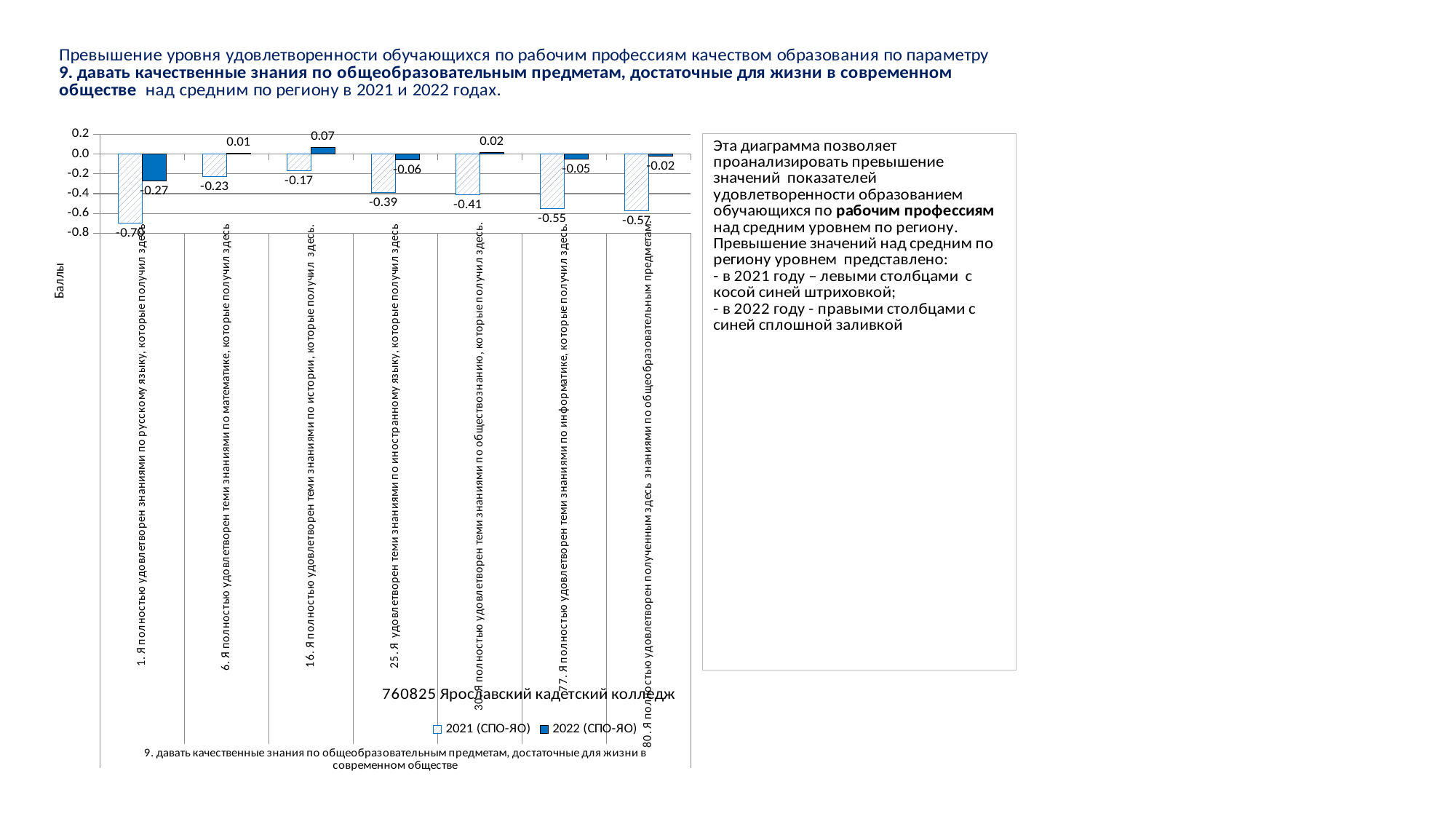
How many series does the chart legend list? 2 Which statement has the highest 2022 (СПО-ЯО) value? 16. Я полностью удовлетворен теми знаниями по истории, которые получил здесь What is the 2021 (СПО-ЯО) value for the statement about knowledge in informatics (77. ... по информатике)? -0.55 What is the 2022 (СПО-ЯО) value for the statement about knowledge in mathematics (6. ... по математике)? 0.01 How many categories (statements) are plotted on the x axis of the chart? 7 What is the difference between the 2022 and 2021 values for the statement about foreign language (25. ... по иностранному языку)? 0.33 What is the 2022 (СПО-ЯО) value for the statement about knowledge in history (16. ... по истории)? 0.07 What is the 2022 (СПО-ЯО) value for the statement about knowledge in social studies (30. ... по обществознанию)? 0.02 Which is larger: the 2021 value for mathematics (6.) or the 2021 value for informatics (77.)? mathematics (6.), -0.23 Which statement has the lowest 2021 (СПО-ЯО) value? 1. Я полностью удовлетворен знаниями по русскому языку, которые получил здесь What is the title shown on the chart? 760825 Ярославский кадетский колледж What kind of chart is shown on the slide? bar chart